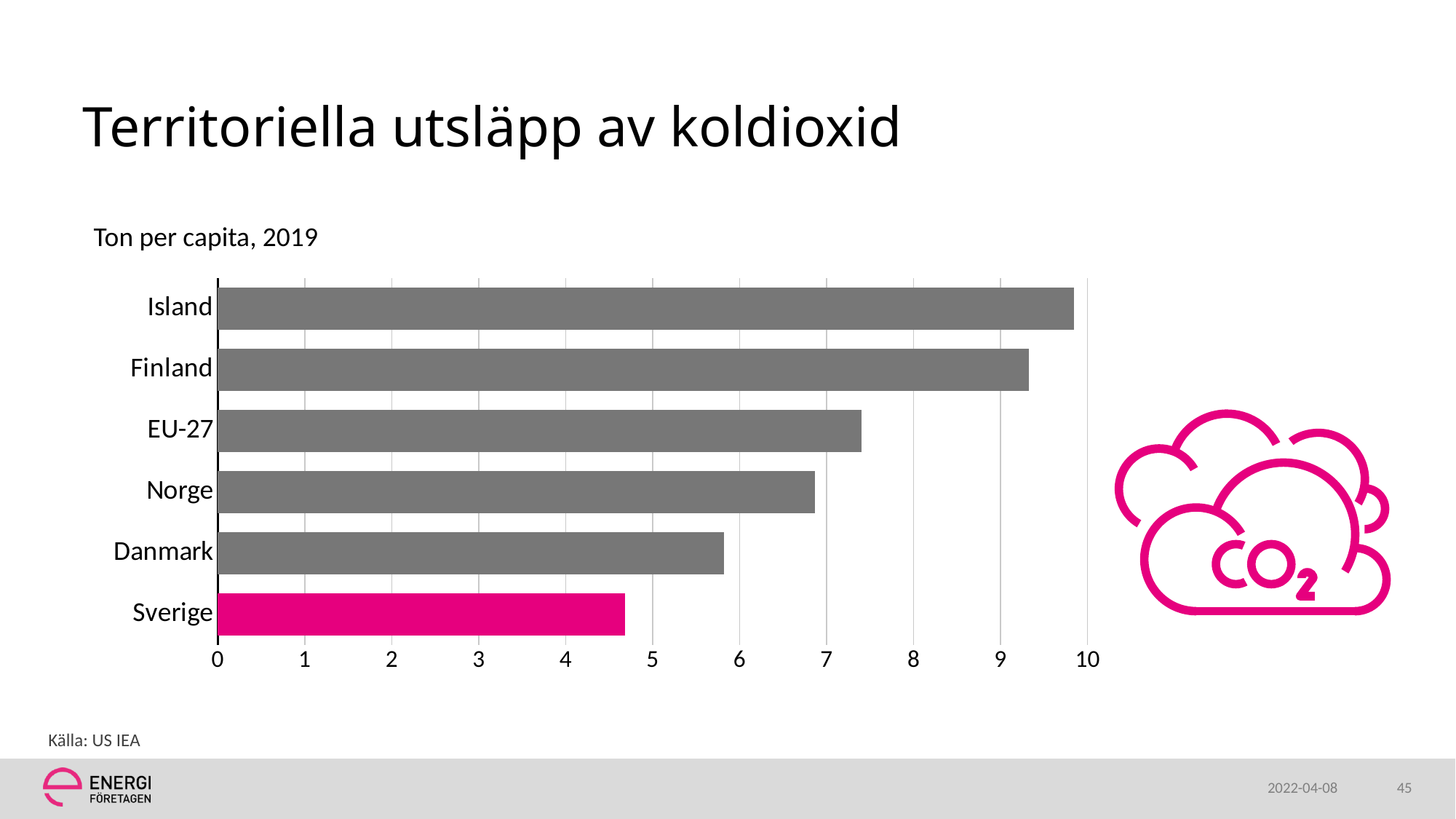
Which has the larger value, Norge or Danmark? Norge What kind of chart is shown on the slide? bar chart Which has the larger value, Finland or EU-27? Finland Is the value for Sverige greater or less than 5? less Which bar in the chart is highlighted in pink rather than grey? Sverige Which country or region has the lowest territorial CO2 emissions per capita in the chart? Sverige How many countries or regions are shown in the chart? 6 Is the value for Danmark greater or less than 6? less Is the value for Island greater or less than 9? greater Which country or region has the highest territorial CO2 emissions per capita in the chart? Island